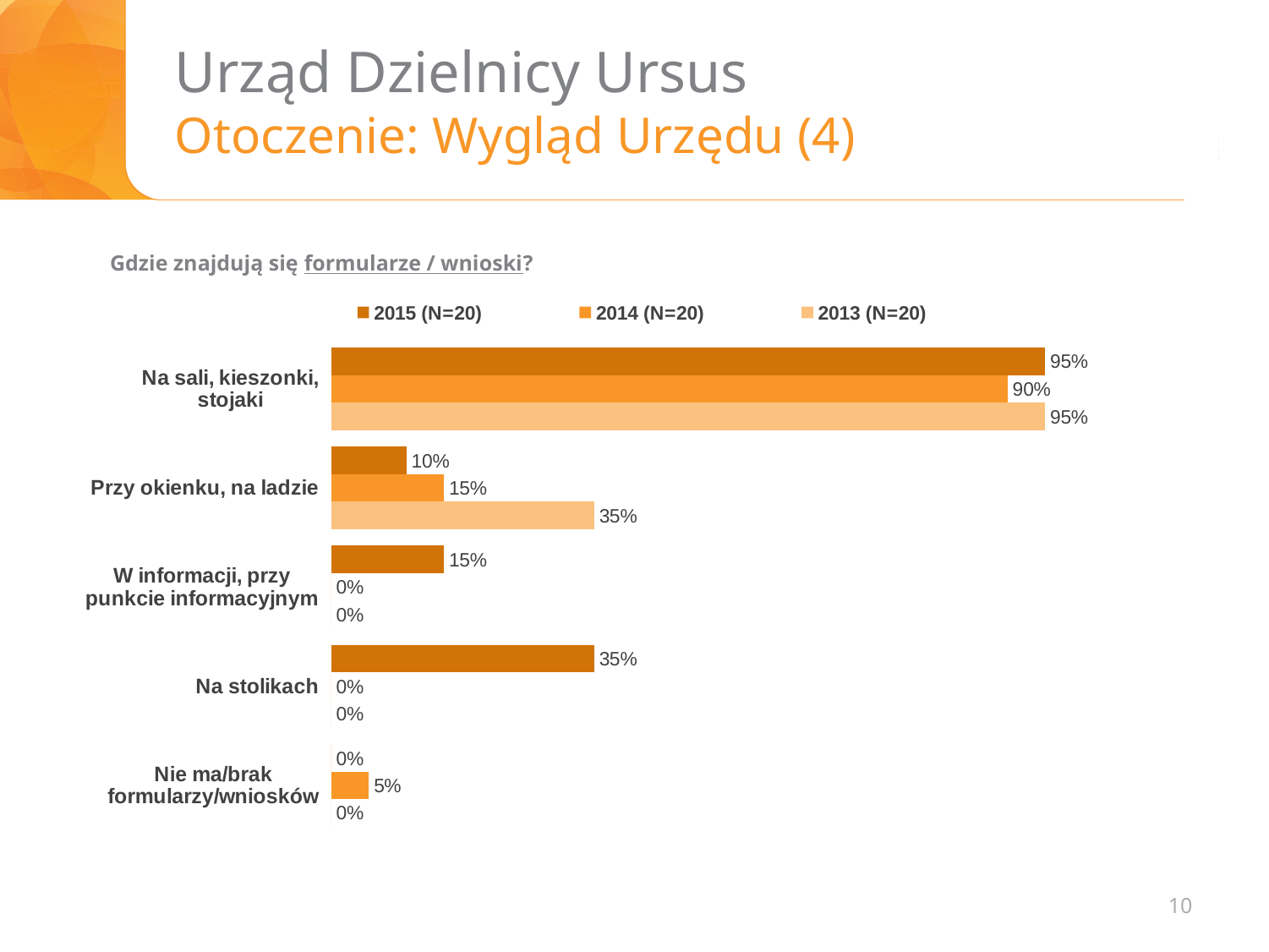
What is the value for "Na sali, kieszonki, stojaki" in the 2015 (N=20) series? 95% What kind of chart is shown on the slide? Bar chart What is the value for "W informacji, przy punkcie informacyjnym" in the 2015 (N=20) series? 15% How many categories are shown on the chart? 5 What question does the chart answer, as stated above it? Gdzie znajdują się formularze / wnioski? How many series does the legend list? 3 What is the value for "Nie ma/brak formularzy/wniosków" in the 2014 (N=20) series? 5% What is the difference between the 2013 (N=20) and 2015 (N=20) values for "Przy okienku, na ladzie"? 25% Which is larger for "Na sali, kieszonki, stojaki": the 2015 (N=20) value or the 2014 (N=20) value? 2015 (N=20) What is the value for "Przy okienku, na ladzie" in the 2013 (N=20) series? 35% What is the value for "Na stolikach" in the 2015 (N=20) series? 35% Which category has the highest value in the 2014 (N=20) series? Na sali, kieszonki, stojaki